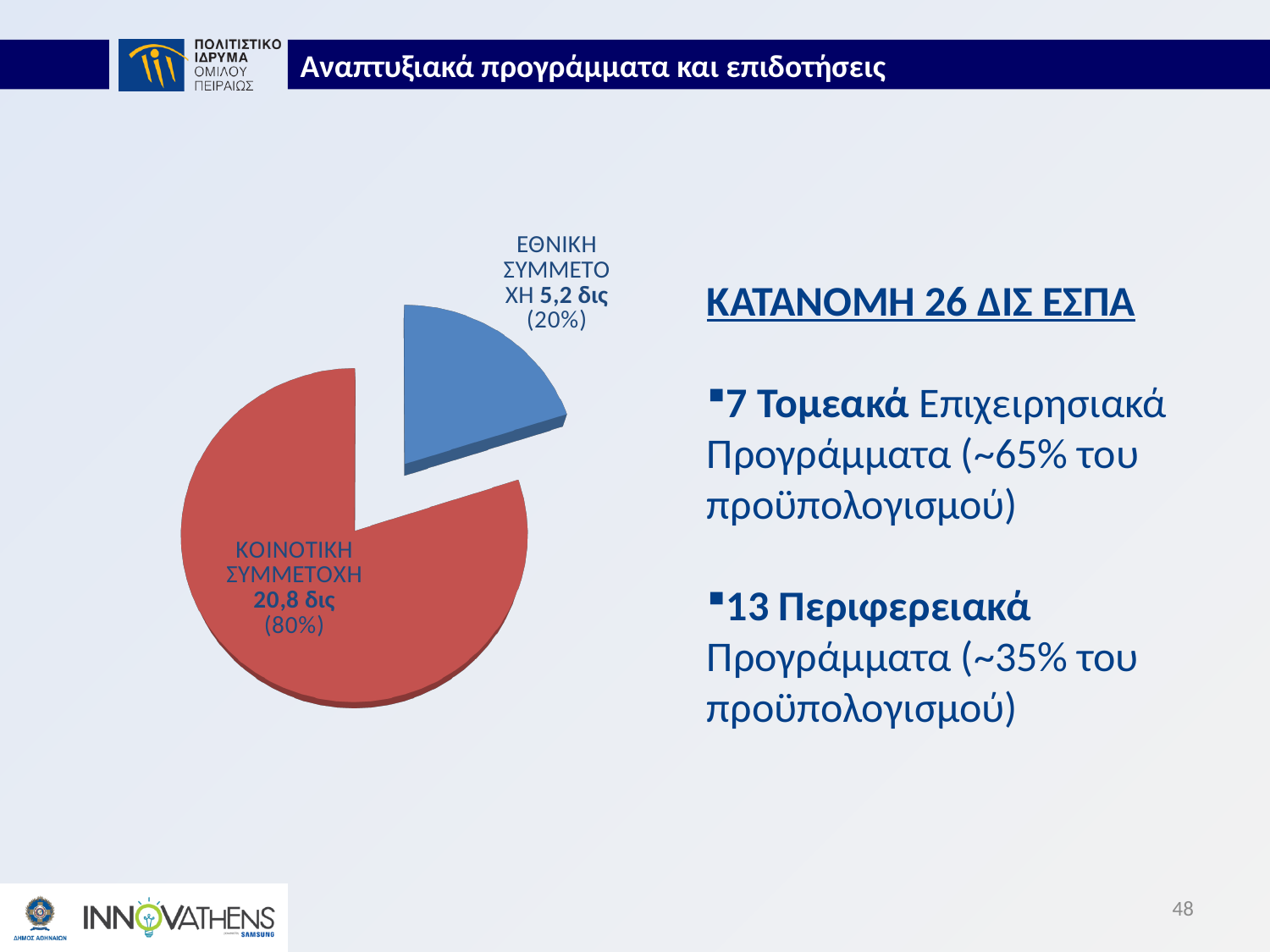
What colour is the ΕΘΝΙΚΗ ΣΥΜΜΕΤΟΧΗ slice in the pie chart? Blue Which slice of the pie chart is the smallest? ΕΘΝΙΚΗ ΣΥΜΜΕΤΟΧΗ What kind of chart is shown on the slide? Pie chart Which is larger, ΕΘΝΙΚΗ ΣΥΜΜΕΤΟΧΗ or ΚΟΙΝΟΤΙΚΗ ΣΥΜΜΕΤΟΧΗ? ΚΟΙΝΟΤΙΚΗ ΣΥΜΜΕΤΟΧΗ What is the difference in δις between ΚΟΙΝΟΤΙΚΗ ΣΥΜΜΕΤΟΧΗ and ΕΘΝΙΚΗ ΣΥΜΜΕΤΟΧΗ? 15,6 δις How many slices does the pie chart have? 2 Which slice of the pie chart is the largest? ΚΟΙΝΟΤΙΚΗ ΣΥΜΜΕΤΟΧΗ What value is shown for ΕΘΝΙΚΗ ΣΥΜΜΕΤΟΧΗ in the pie chart? 5,2 δις What value is shown for ΚΟΙΝΟΤΙΚΗ ΣΥΜΜΕΤΟΧΗ in the pie chart? 20,8 δις What share of the pie does ΚΟΙΝΟΤΙΚΗ ΣΥΜΜΕΤΟΧΗ represent? 80% What is the total of the two slices in the pie chart, in δις? 26 δις What share of the pie does ΕΘΝΙΚΗ ΣΥΜΜΕΤΟΧΗ represent? 20%